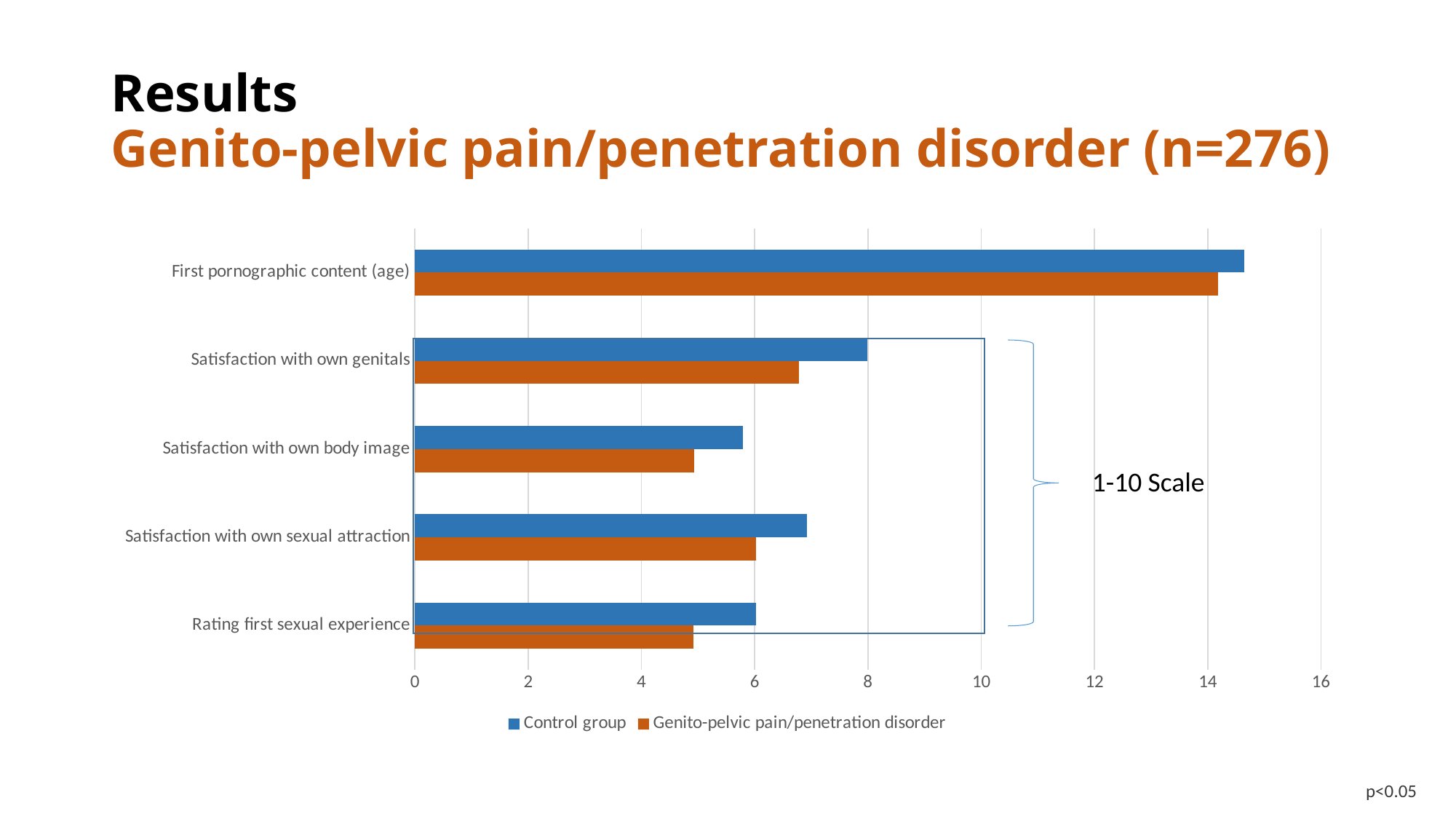
How many categories are plotted on the chart? 5 What scale does the annotation next to the bracket say the four satisfaction/rating items use? 1-10 Scale For the Control group, which is larger: Satisfaction with own body image or Satisfaction with own sexual attraction? Satisfaction with own sexual attraction Is the Control group value for Satisfaction with own sexual attraction greater or less than 6? greater For Satisfaction with own genitals, which series has the larger value: Control group or Genito-pelvic pain/penetration disorder? Control group How many series does the legend list? 2 Which category has the highest value for the Control group? First pornographic content (age) Is the Genito-pelvic pain/penetration disorder value for Satisfaction with own genitals greater or less than 6? greater What colour are the bars for the Control group series? blue What kind of chart is shown on the slide? bar chart Is the Control group value for First pornographic content (age) greater or less than 14? greater